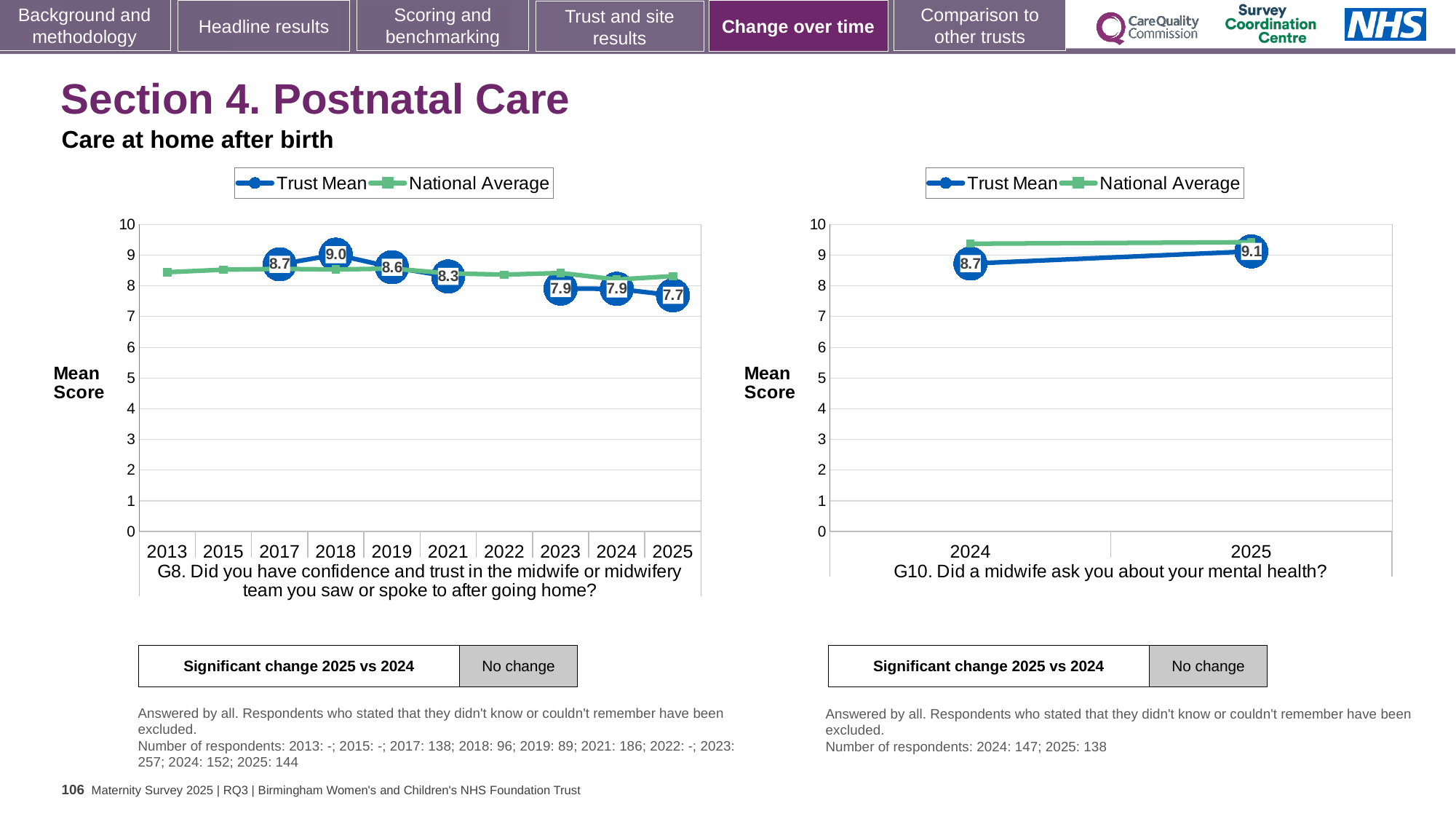
In the G8 chart, is the Trust Mean higher in 2017 or in 2021? 2017 How many series does the legend of the G10 chart list? 2 In the G8 chart, which year has the highest Trust Mean? 2018 In the G10 chart, what is the difference between the Trust Mean for 2025 and 2024? 0.4 In the G8 chart, what is the Trust Mean for 2018? 9.0 How many years are shown on the x axis of the G8 chart? 10 In the G10 chart, what is the Trust Mean for 2025? 9.1 What kind of chart is the G8 chart? Line chart In the G8 chart, what is the Trust Mean for 2025? 7.7 In the G8 chart, does the Trust Mean rise or fall from 2018 to 2025? Fall In the G10 chart, is the National Average for 2024 greater or less than 9? greater In the G8 chart, which year has the lowest Trust Mean? 2025